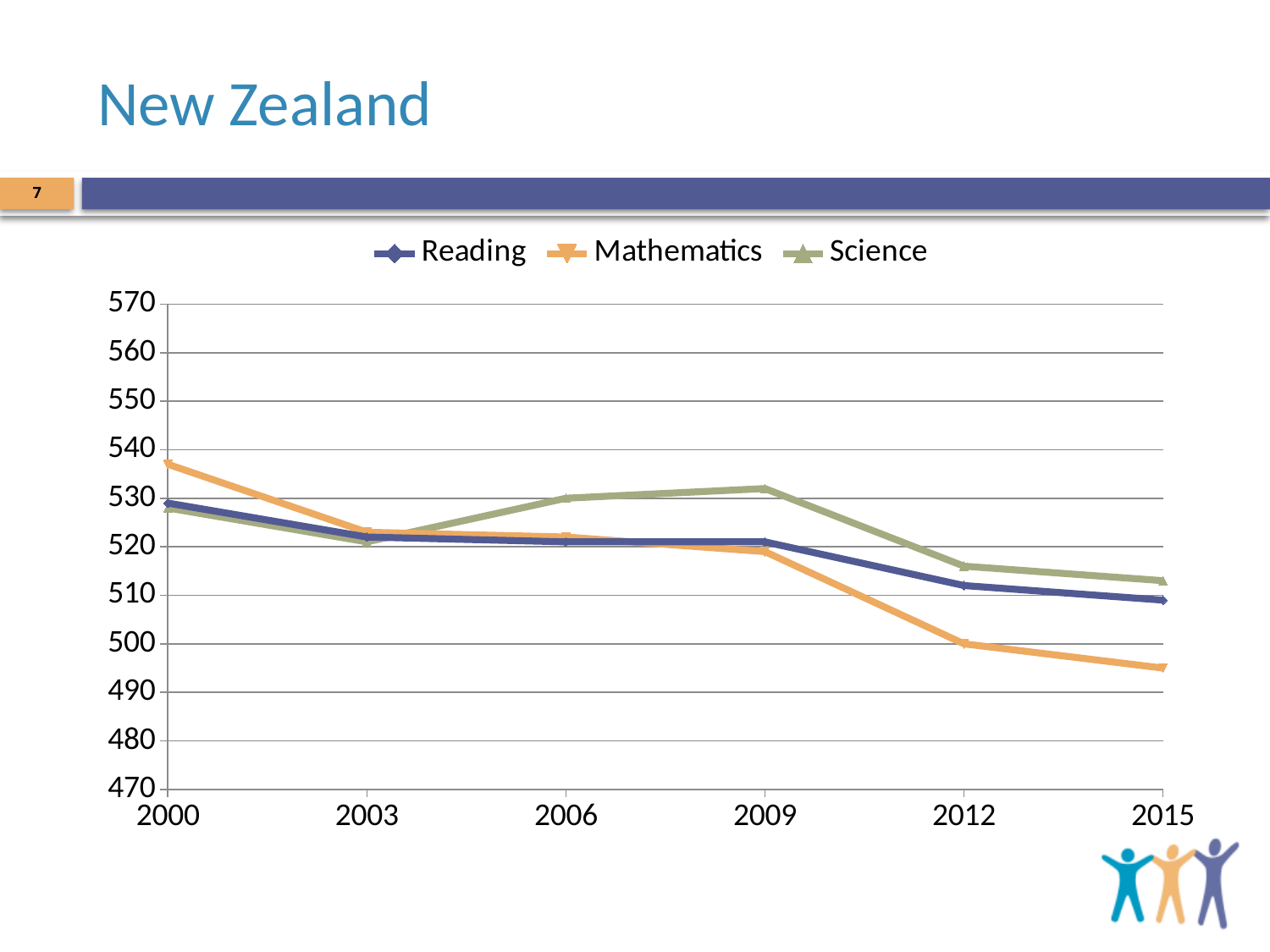
Does the Mathematics line rise or fall from 2000 to 2015? fall Is the Mathematics value for 2000 greater or less than 530? greater What kind of chart is shown on the slide? line chart How many series does the legend list? 3 Is the Mathematics value for 2015 greater or less than 500? less What are the three series named in the legend? Reading, Mathematics, Science Is the Science value for 2012 greater or less than 520? less Which series has the highest value in 2015? Science Which series has the highest value in 2000? Mathematics Which series has the lowest value in 2015? Mathematics In 2009, which is larger, the Science value or the Reading value? Science How many years are shown along the x axis? 6